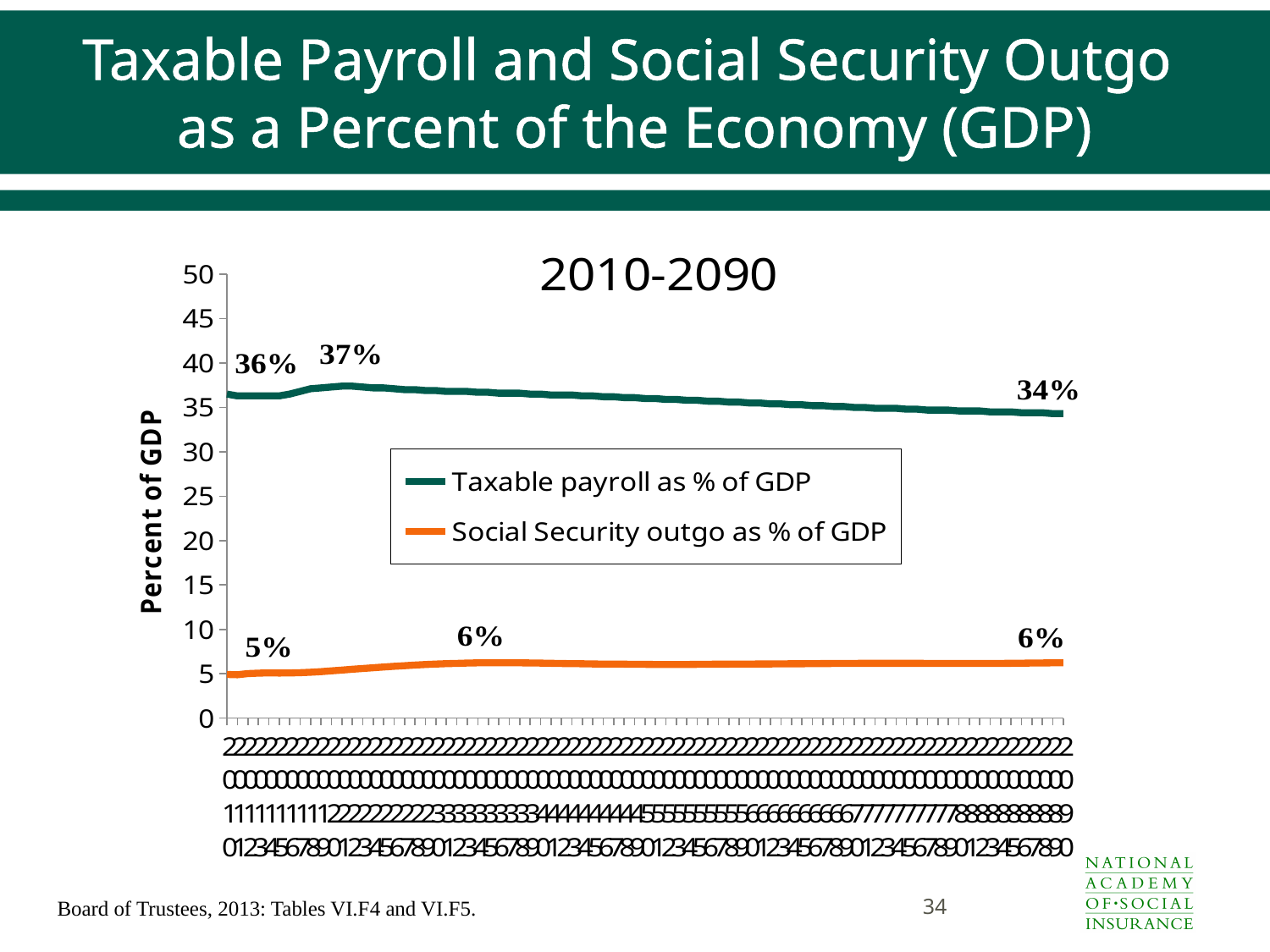
What is the labelled value of Social Security outgo as % of GDP at the start of the period (2010)? 5% By how many percentage points does the labelled taxable payroll value at the start (36%) exceed the labelled value at the end (34%)? 2 percentage points What is the labelled value of Social Security outgo as % of GDP at the end of the period (2090)? 6% What is the highest labelled value shown for taxable payroll as % of GDP? 37% What is the labelled value of taxable payroll as % of GDP at the start of the period (2010)? 36% Overall, does taxable payroll as % of GDP rise or fall from the start of the period to the end? fall What is the title of the chart's vertical axis? Percent of GDP What kind of chart is shown on the slide? line chart Is the value of Social Security outgo as % of GDP greater or less than 10 throughout the chart? less What is the labelled value of taxable payroll as % of GDP at the end of the period (2090)? 34% How many series does the chart's legend list? 2 Which series has higher values throughout the chart, taxable payroll or Social Security outgo? Taxable payroll as % of GDP